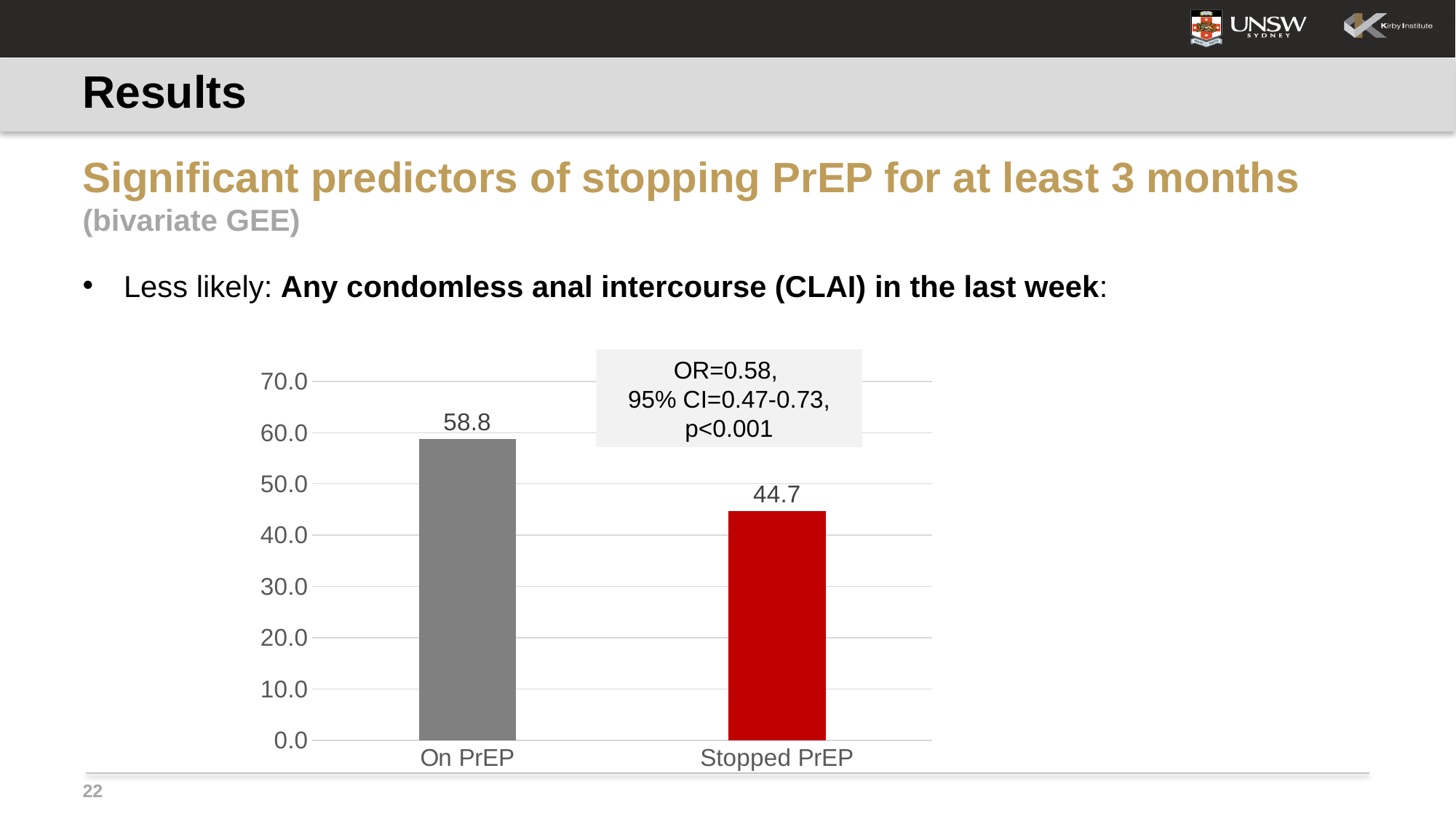
Is the value for On PrEP greater or less than 50.0? greater What is the value for On PrEP? 58.8 Is the value for Stopped PrEP greater or less than 50.0? less What colour is the bar for Stopped PrEP? red What is the odds ratio shown in the text box on the chart? 0.58 What is the difference between the values for On PrEP and Stopped PrEP? 14.1 Which is larger, the value for On PrEP or the value for Stopped PrEP? On PrEP Which category has the lowest value? Stopped PrEP What kind of chart is shown on the slide? bar chart Which category has the highest value? On PrEP How many categories are shown on the x axis? 2 What is the value for Stopped PrEP? 44.7